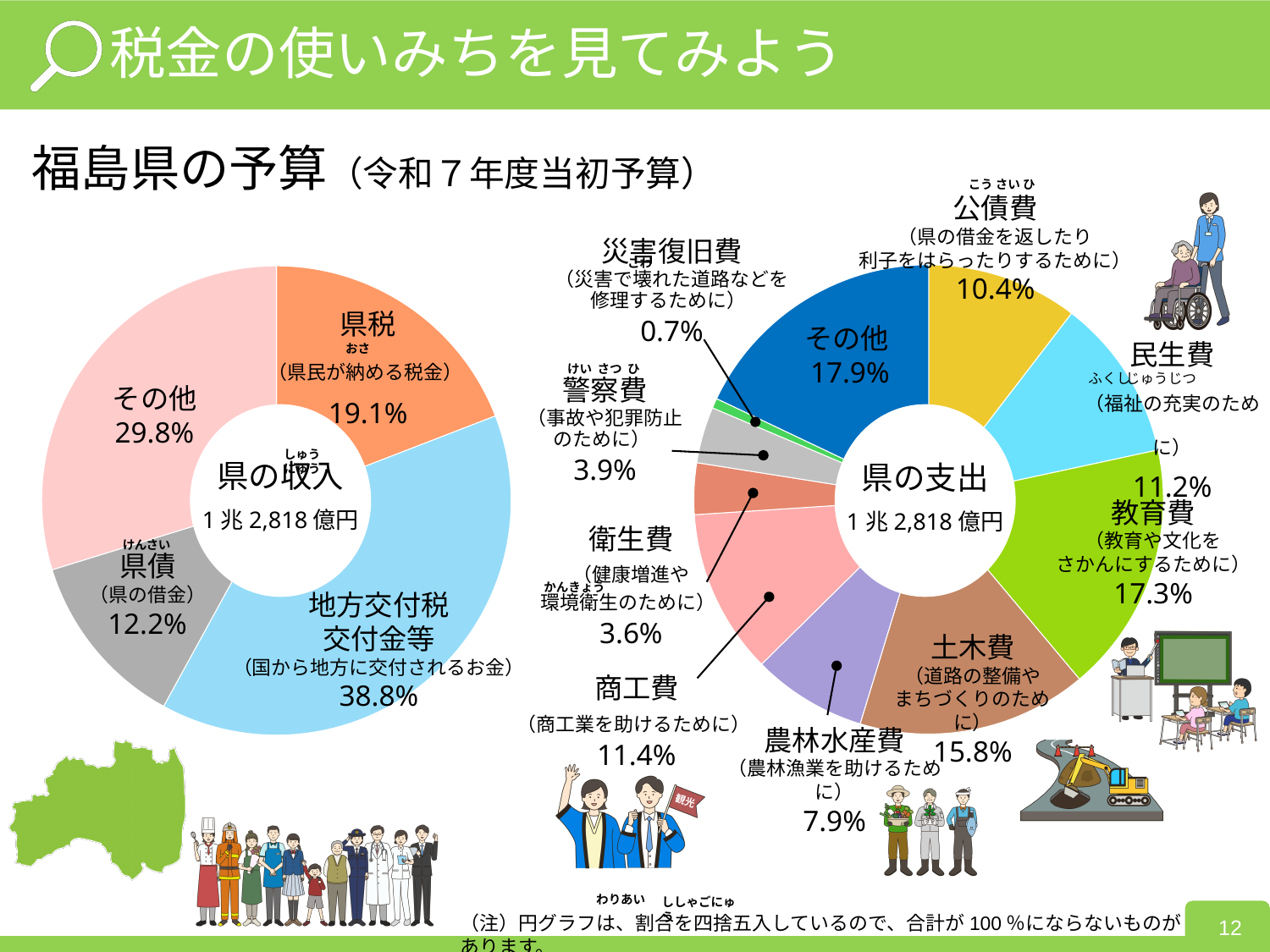
In the 県の支出 chart, what share is 教育費? 17.3% In the 県の収入 chart, what share is 県債? 12.2% In the 県の支出 chart, what is the difference between 商工費 and 農林水産費? 3.5% In the 県の収入 chart, which category has the smallest share? 県債 In the 県の収入 chart, what share is 地方交付税交付金等? 38.8% In the 県の支出 chart, what share is 災害復旧費? 0.7% In the 県の収入 chart, what is the difference between その他 and 県税? 10.7% In the 県の支出 chart, which category has the smallest share? 災害復旧費 In the 県の収入 chart, which category has the largest share? 地方交付税交付金等 In the 県の支出 chart, which is larger, 土木費 or 民生費? 土木費 What kind of chart is the 県の収入 chart? Pie (donut) chart How many categories does the 県の支出 chart show? 10